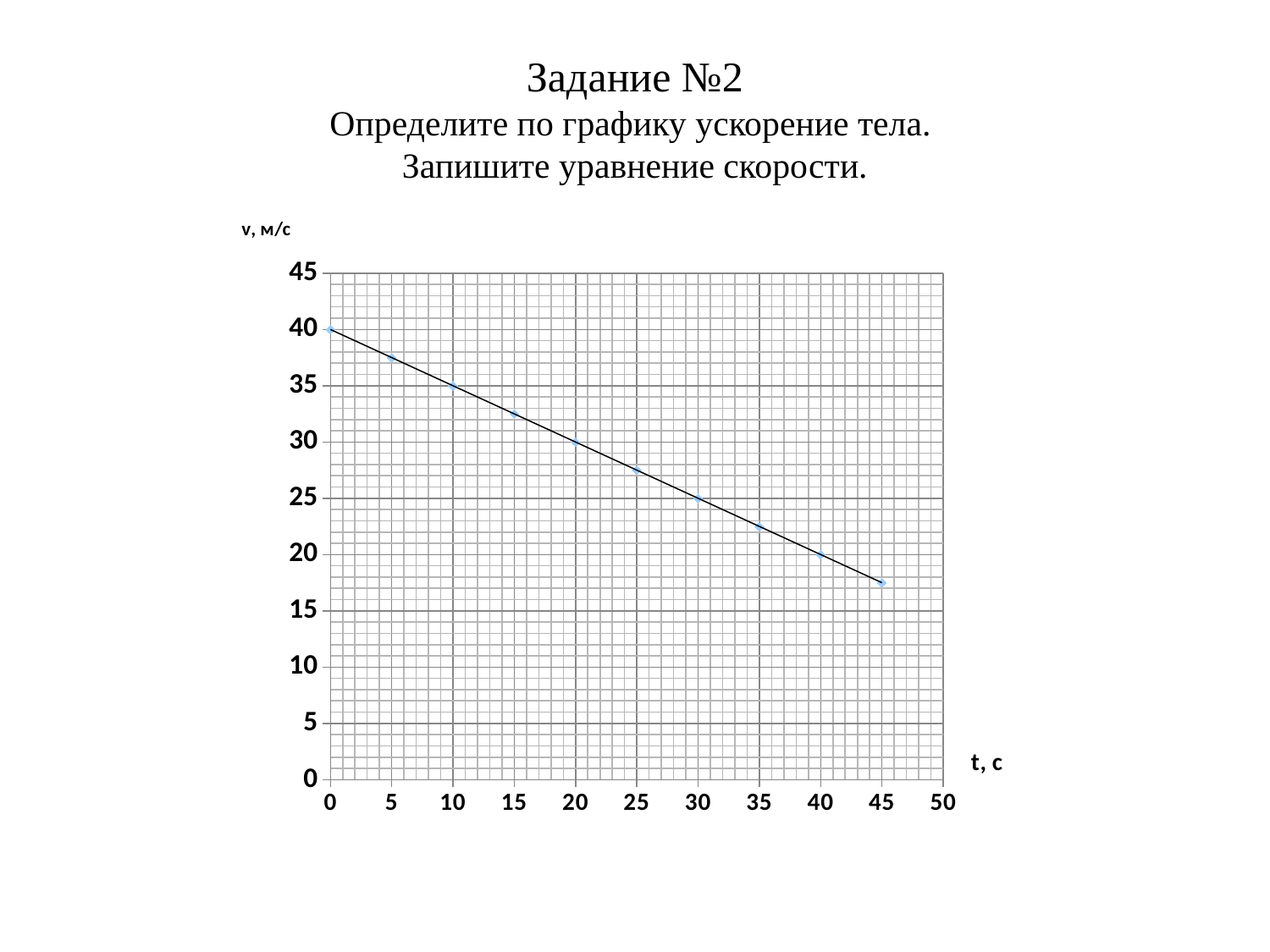
Do the values of v rise or fall as t increases? fall At which value of t is v highest? 0 What is the difference between v at t = 0 and v at t = 40? 20 Is the value of v at t = 25 greater or less than 30? less What is the value of v at t = 40? 20 Is the value of v at t = 45 greater or less than 20? less Is the value of v at t = 5 greater or less than 35? greater What is the value of v at t = 0? 40 At which value of t is v lowest? 45 What is the value of v at t = 10? 35 What kind of chart is shown on the slide? line chart What is the value of v at t = 20? 30